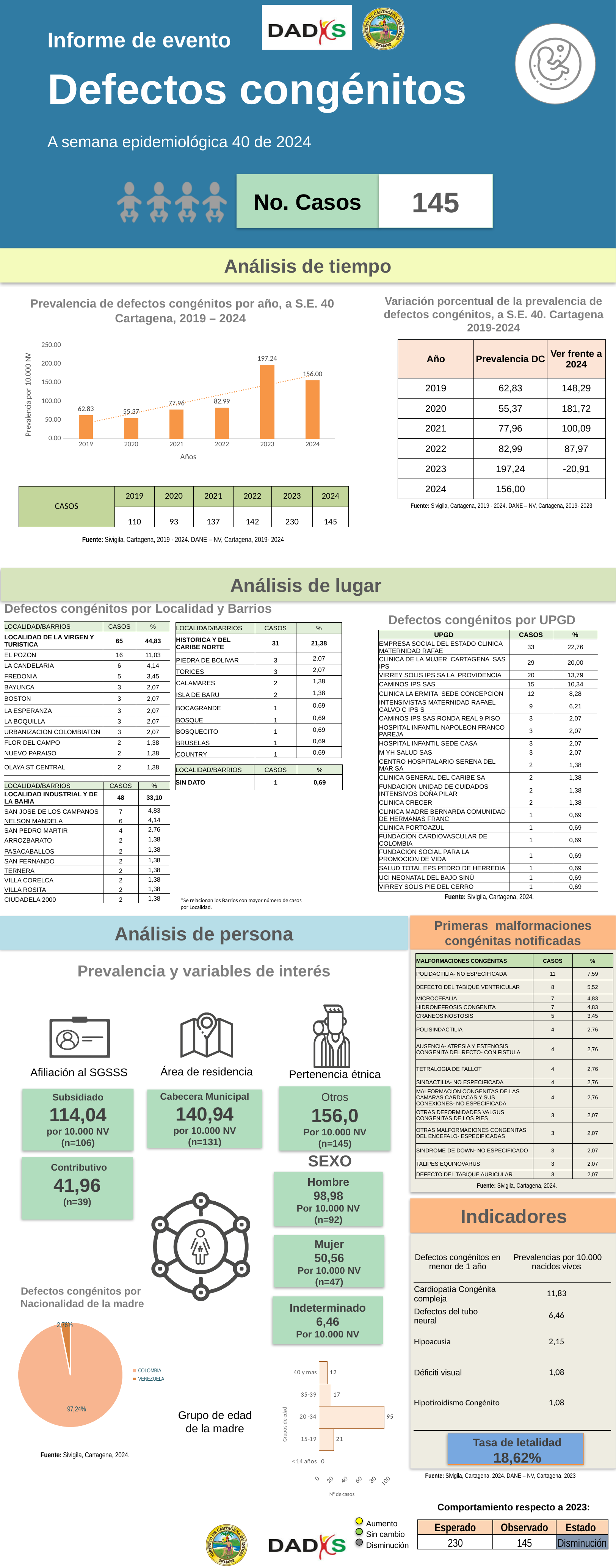
In the chart 'Prevalencia de defectos congénitos por año, a S.E. 40 Cartagena, 2019 – 2024', what is the difference between the values for 2023 and 2024? 41.24 In the chart 'Grupo de edad de la madre', how many cases are in the 20-34 age group? 95 In the chart 'Prevalencia de defectos congénitos por año, a S.E. 40 Cartagena, 2019 – 2024', what is the value for 2020? 55.37 In the pie chart 'Defectos congénitos por Nacionalidad de la madre', what share does COLOMBIA have? 97,24% In the chart 'Prevalencia de defectos congénitos por año, a S.E. 40 Cartagena, 2019 – 2024', which year has the highest prevalence? 2023 In the chart 'Grupo de edad de la madre', which is larger, the value for 35-39 or the value for 15-19? 15-19 In the chart 'Prevalencia de defectos congénitos por año, a S.E. 40 Cartagena, 2019 – 2024', which year has the lowest prevalence? 2020 What kind of chart is 'Prevalencia de defectos congénitos por año, a S.E. 40 Cartagena, 2019 – 2024'? Bar chart In the chart 'Prevalencia de defectos congénitos por año, a S.E. 40 Cartagena, 2019 – 2024', what is the value for 2023? 197.24 In the chart 'Grupo de edad de la madre', which age group has the most cases? 20 -34 In the pie chart 'Defectos congénitos por Nacionalidad de la madre', what share does VENEZUELA have? 2,76% In the chart 'Prevalencia de defectos congénitos por año, a S.E. 40 Cartagena, 2019 – 2024', how many years are plotted? 6